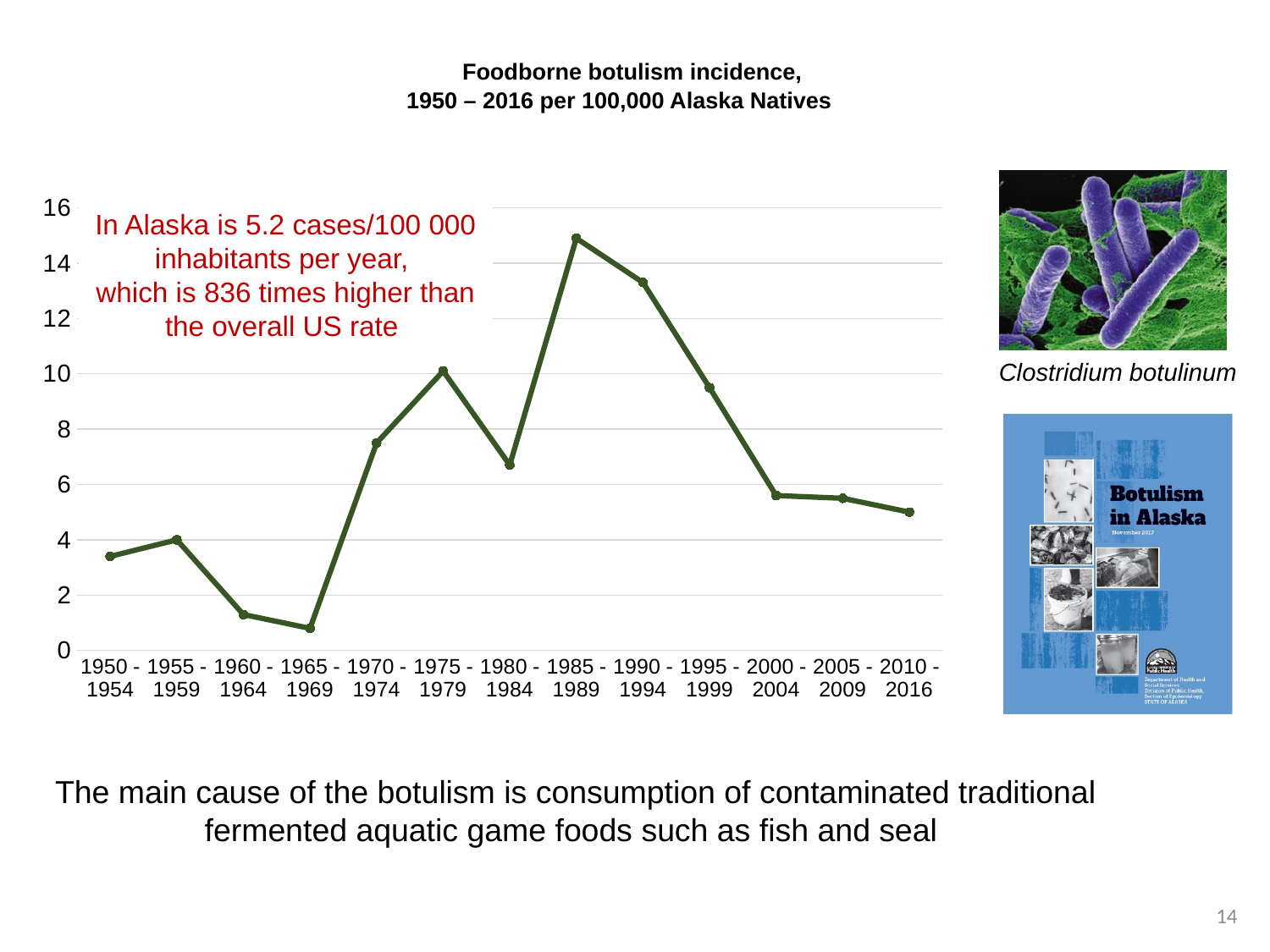
What is the title of the chart? Foodborne botulism incidence, 1950 – 2016 per 100,000 Alaska Natives Is the value for 1950 - 1954 greater or less than 4? less Is the value for 1985 - 1989 greater or less than 14? greater Is the value for 1990 - 1994 greater or less than 12? greater Which is larger, the value for 1975 - 1979 or the value for 1980 - 1984? 1975 - 1979 Which time period has the lowest incidence? 1965 - 1969 How many time periods are plotted along the x axis? 13 Which is larger, the value for 1995 - 1999 or the value for 2000 - 2004? 1995 - 1999 Which time period has the highest incidence? 1985 - 1989 Do the values rise or fall from 1985 - 1989 to 2010 - 2016? fall What kind of chart is shown on the slide? line chart